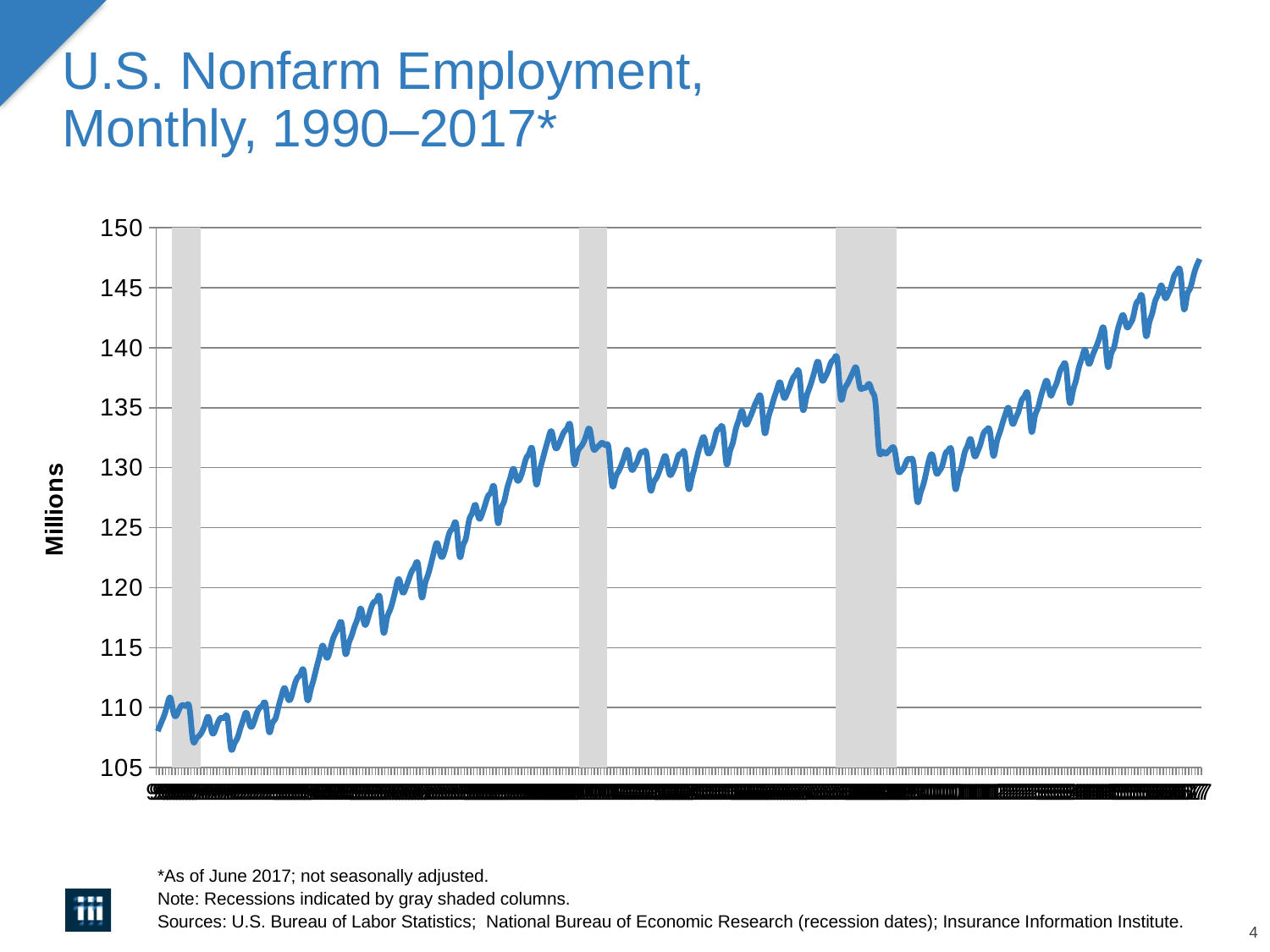
What is the title of the chart? U.S. Nonfarm Employment, Monthly, 1990–2017* Does the line ever exceed 150 on the y-axis? no What unit does the y-axis label indicate? Millions Is the value at the end of the series larger or smaller than the value at the start of the series? larger Is the value at the start of the series in 1990 greater or less than 110? less Does the series reach its highest value at the beginning or at the end of the period shown? at the end Overall, does U.S. nonfarm employment rise or fall from 1990 to 2017? rise What kind of chart is shown on the slide? line chart How many gray shaded recession columns are shown on the chart? 3 Is the peak reached just before the third (rightmost) gray recession column greater or less than 135? greater